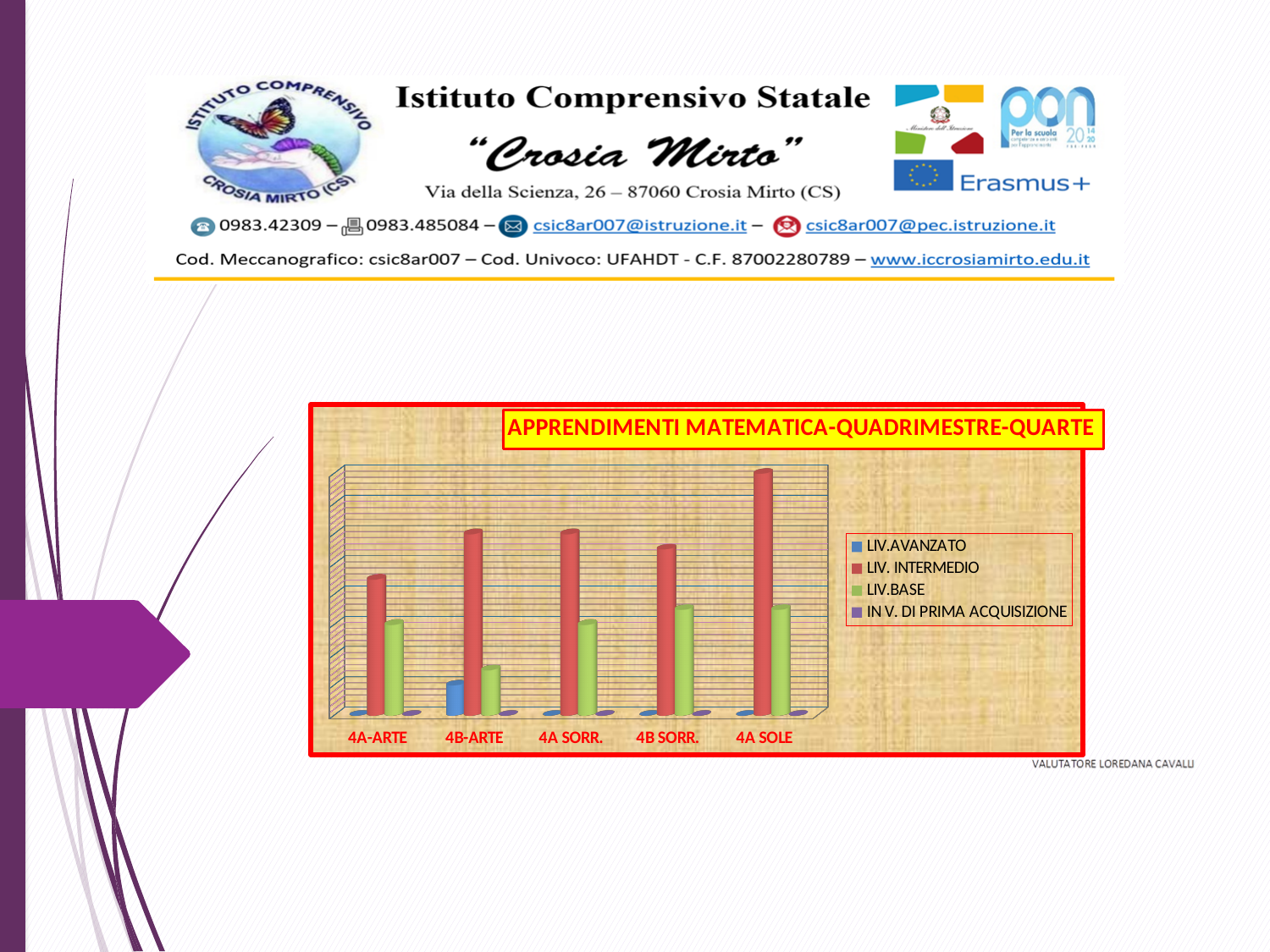
What is the title of the chart? APPRENDIMENTI MATEMATICA-QUADRIMESTRE-QUARTE How many classes (categories) are shown on the x axis of the chart? 5 Which colour represents LIV. INTERMEDIO in the chart? Red Is the LIV. INTERMEDIO bar larger for 4A-ARTE or for 4A SOLE? 4A SOLE Which class has the highest LIV. INTERMEDIO bar? 4A SOLE Which class has the lowest LIV.BASE bar? 4B-ARTE Which class is the only one with a visible LIV.AVANZATO bar? 4B-ARTE For 4A-ARTE, which is larger: LIV. INTERMEDIO or LIV.BASE? LIV. INTERMEDIO How many series does the chart legend list? 4 For 4B-ARTE, which is larger: LIV.AVANZATO or LIV.BASE? LIV.BASE What kind of chart is shown on the slide? Bar chart Which class has the lowest LIV. INTERMEDIO bar? 4A-ARTE